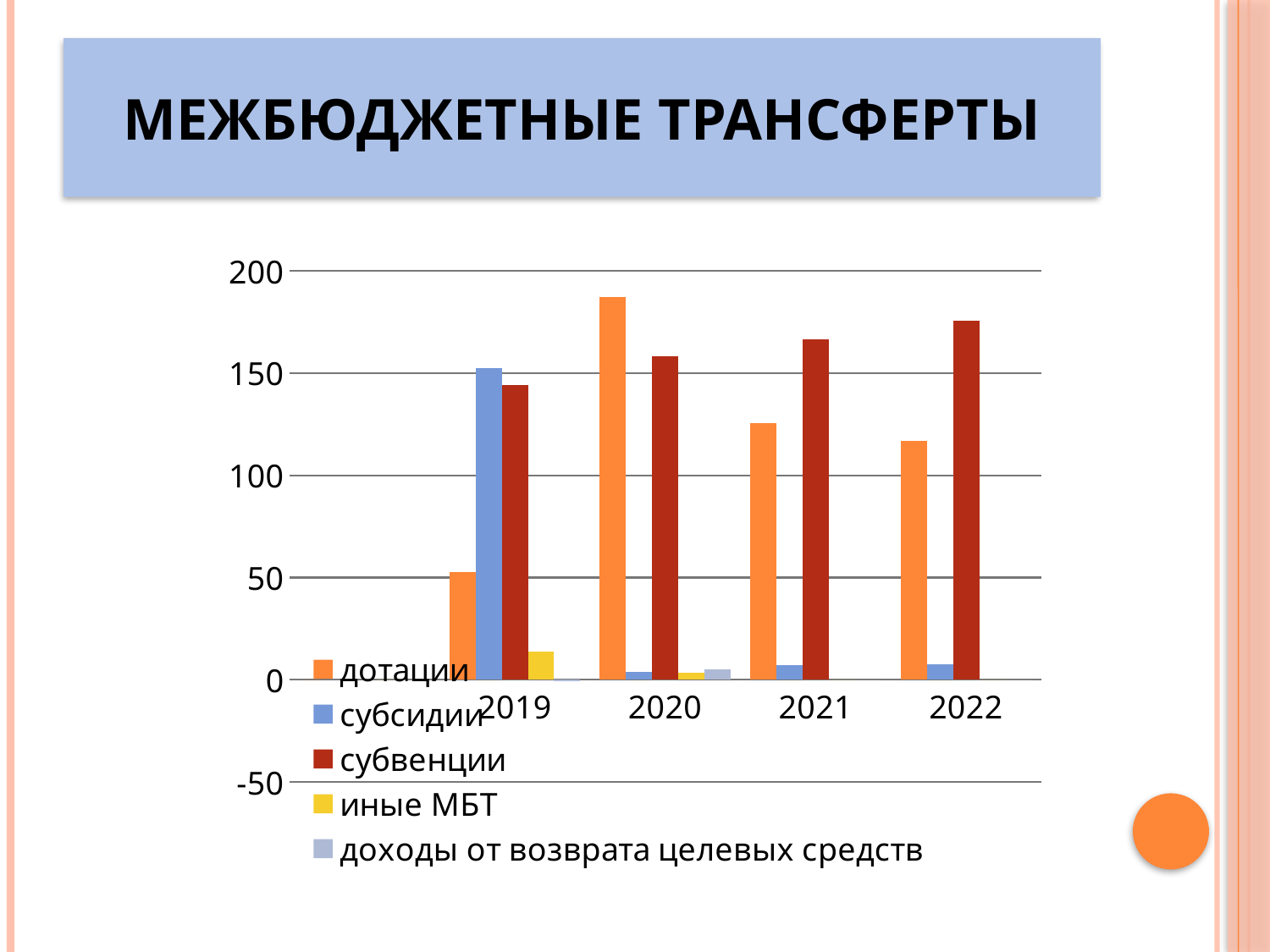
How many series does the chart legend list? 5 Is the value for дотации in 2019 greater or less than 100? less Is the value for дотации in 2020 greater or less than 150? greater In 2021, which is larger: дотации or субвенции? субвенции Do the values for субвенции rise or fall from 2019 to 2022? rise In which year is the value for дотации the highest? 2020 Is the value for субсидии in 2019 greater or less than 100? greater In which year is the value for субвенции the lowest? 2019 What kind of chart is shown on the slide? bar chart In which year is the value for дотации the lowest? 2019 In which year is the value for субвенции the highest? 2022 How many years are shown on the x axis of the chart? 4